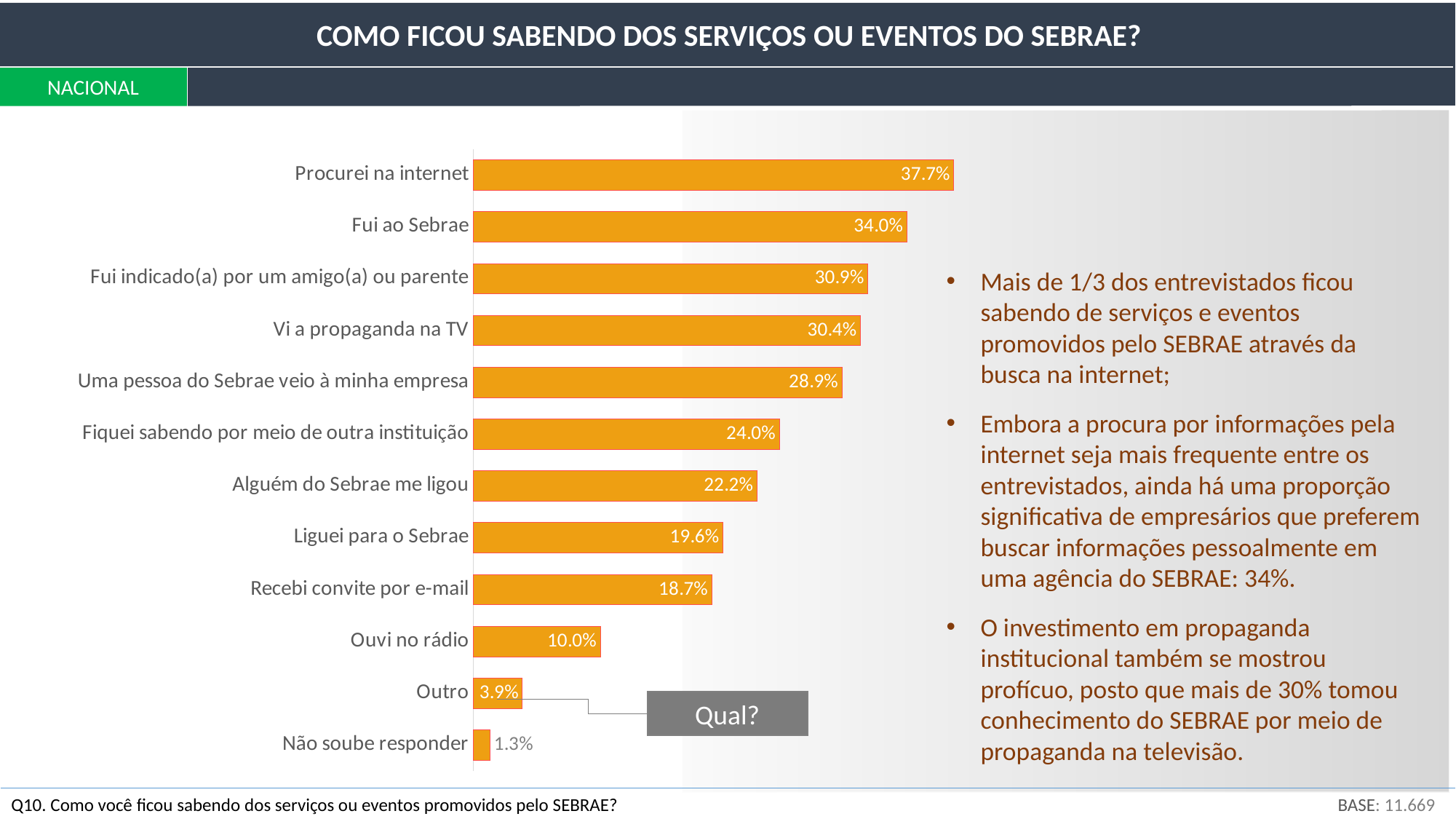
Which category has the highest value? Procurei na internet How many categories are shown in the chart? 12 What is the value for "Fui ao Sebrae"? 34.0% What is the value for "Procurei na internet"? 37.7% Which category has the lowest value? Não soube responder What is the difference between "Procurei na internet" and "Fui ao Sebrae"? 3.7% Which is larger, "Vi a propaganda na TV" or "Uma pessoa do Sebrae veio à minha empresa"? Vi a propaganda na TV What kind of chart is shown on the slide? Bar chart What is the difference between "Fiquei sabendo por meio de outra instituição" and "Alguém do Sebrae me ligou"? 1.8% What is the value for "Recebi convite por e-mail"? 18.7% What is the title of the slide? COMO FICOU SABENDO DOS SERVIÇOS OU EVENTOS DO SEBRAE? What is the value for "Ouvi no rádio"? 10.0%